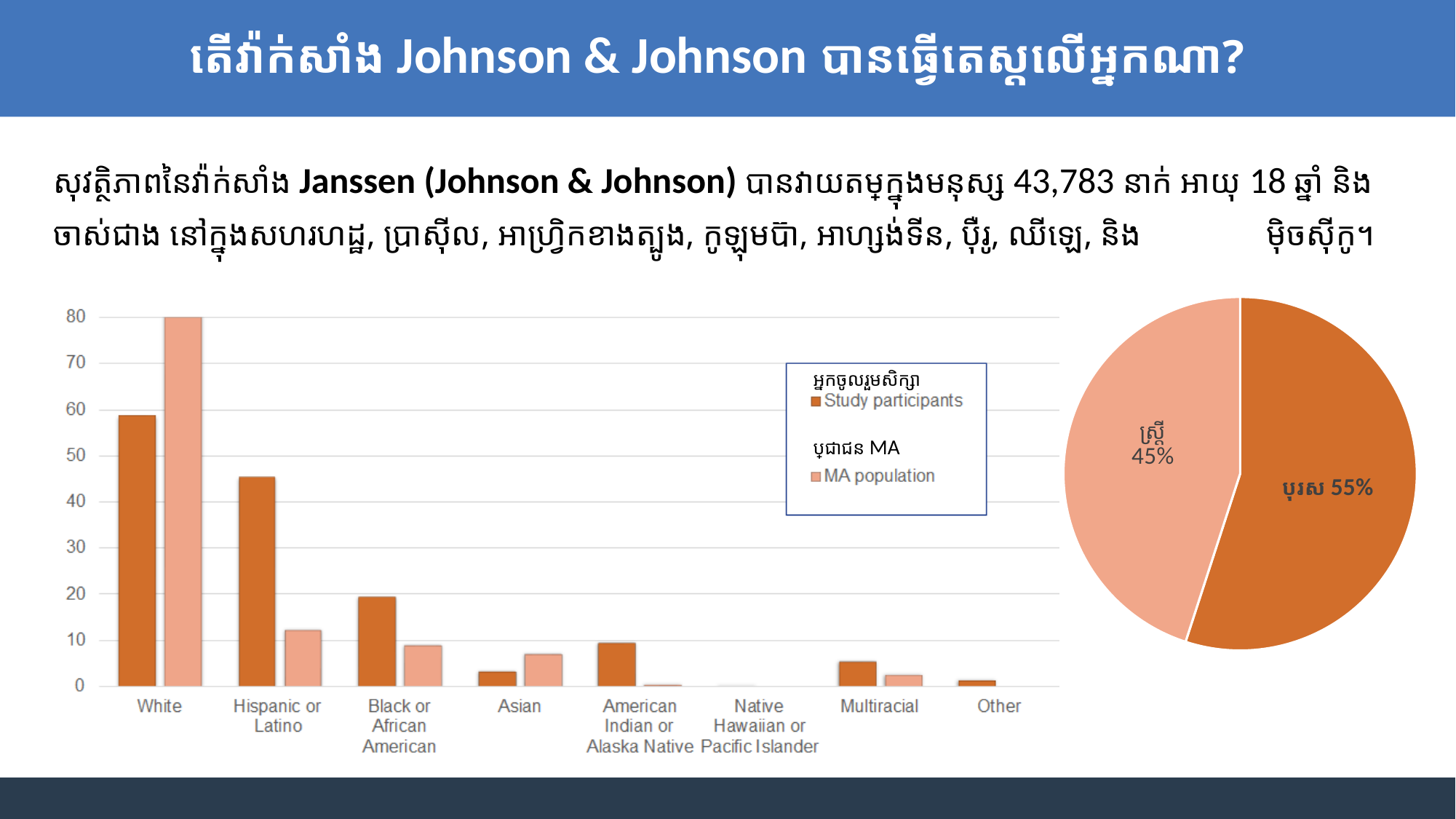
In the bar chart on the left, is the Study participants value for Hispanic or Latino greater or less than 40? greater In the bar chart on the left, which category has the highest Study participants bar? White In the pie chart on the right, which slice is larger, បុរស or ស្ត្រី? បុរស In the bar chart on the left, is the MA population value for Asian greater or less than 10? less In the bar chart on the left, is the Study participants value for White greater or less than 50? greater What kind of chart is the chart on the right of the slide? pie chart In the pie chart on the right, what share of the pie is labelled បុរស? 55% In the bar chart on the left, how many series does the legend list? 2 In the bar chart on the left, which category has the highest MA population bar? White In the bar chart on the left, which is larger for Black or African American: Study participants or MA population? Study participants In the bar chart on the left, how many categories are shown on the x axis? 8 What kind of chart is the chart on the left of the slide? bar chart